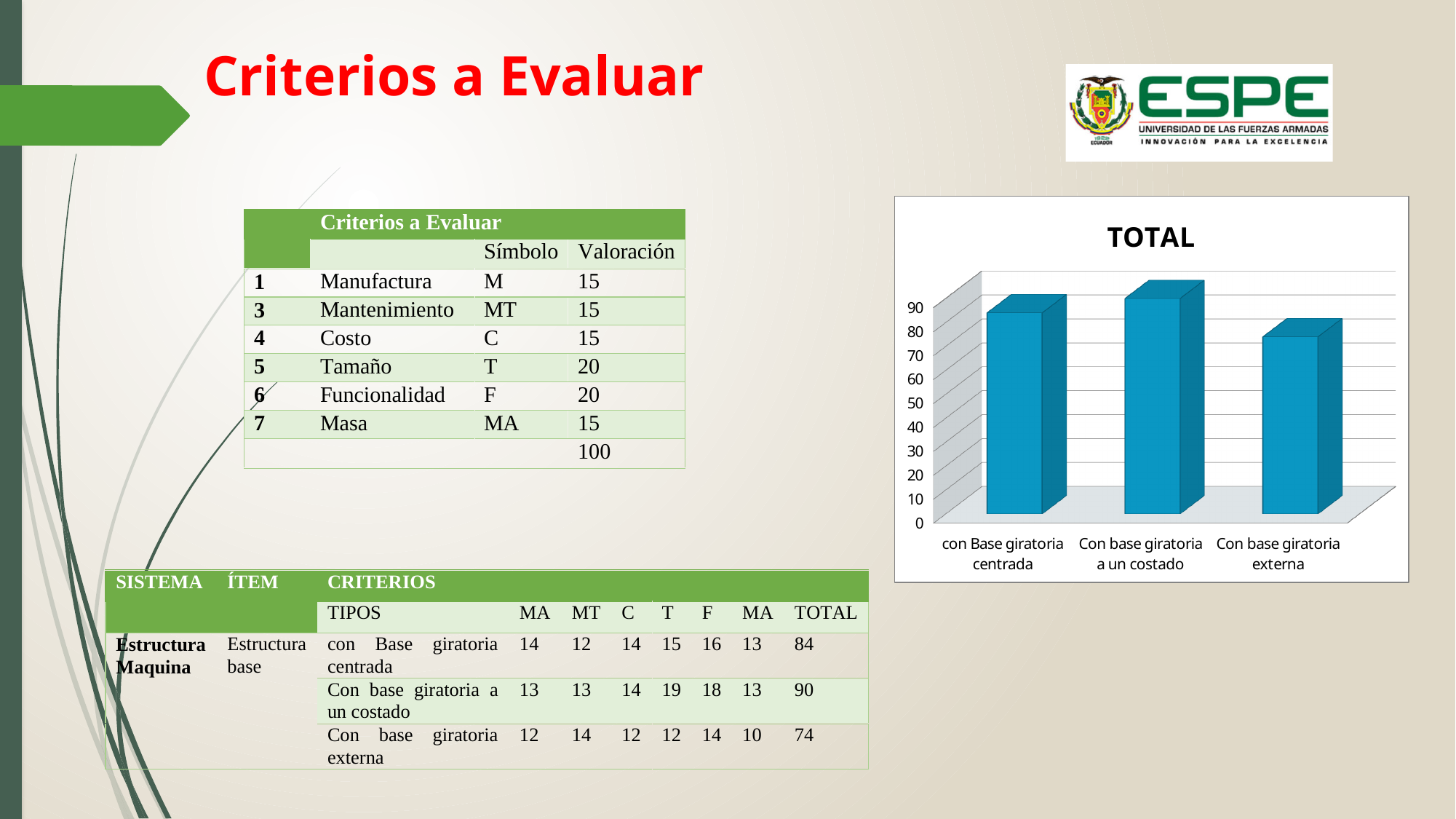
Which is larger in the TOTAL chart: con Base giratoria centrada or Con base giratoria externa? con Base giratoria centrada What kind of chart is shown on the slide? bar chart Is the value for con Base giratoria centrada greater or less than 70? greater Which category has the highest bar in the TOTAL chart? Con base giratoria a un costado Which category has the lowest bar in the TOTAL chart? Con base giratoria externa Do the bars in the TOTAL chart rise or fall from the second category to the third? fall Is the value for Con base giratoria a un costado greater or less than 80? greater How many categories are plotted in the TOTAL chart? 3 Is the value for Con base giratoria externa greater or less than 80? less What is the highest value shown on the vertical axis of the TOTAL chart? 90 What is the title of the chart? TOTAL